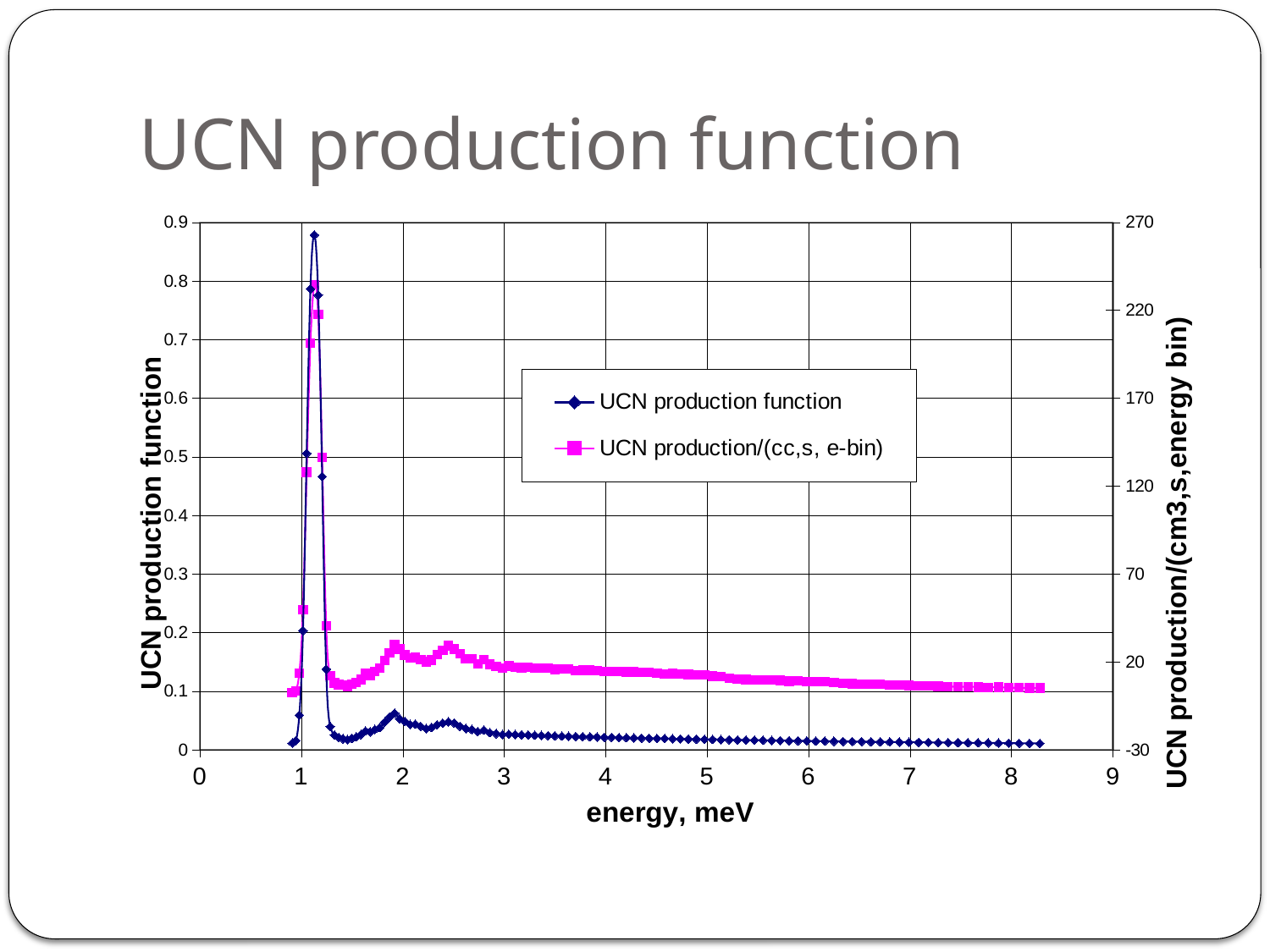
What kind of chart is shown on the slide? line chart What is the maximum value shown on the right-hand y axis? 270 How many series does the legend list? 2 Is the peak value of the UCN production/(cc,s, e-bin) series, read on the right axis, greater or less than 220? greater Is the peak value of the UCN production function series greater or less than 0.8? greater What is the title of the chart? UCN production function Which is larger for the UCN production function series: the value near an energy of 1.1 meV or the value near an energy of 2 meV? near 1.1 meV Is the value of the UCN production function at an energy of 5 meV greater or less than 0.1? less What is the label of the x axis? energy, meV After the peak near 1 meV, do the values of the UCN production function rise or fall as energy increases toward 8 meV? fall